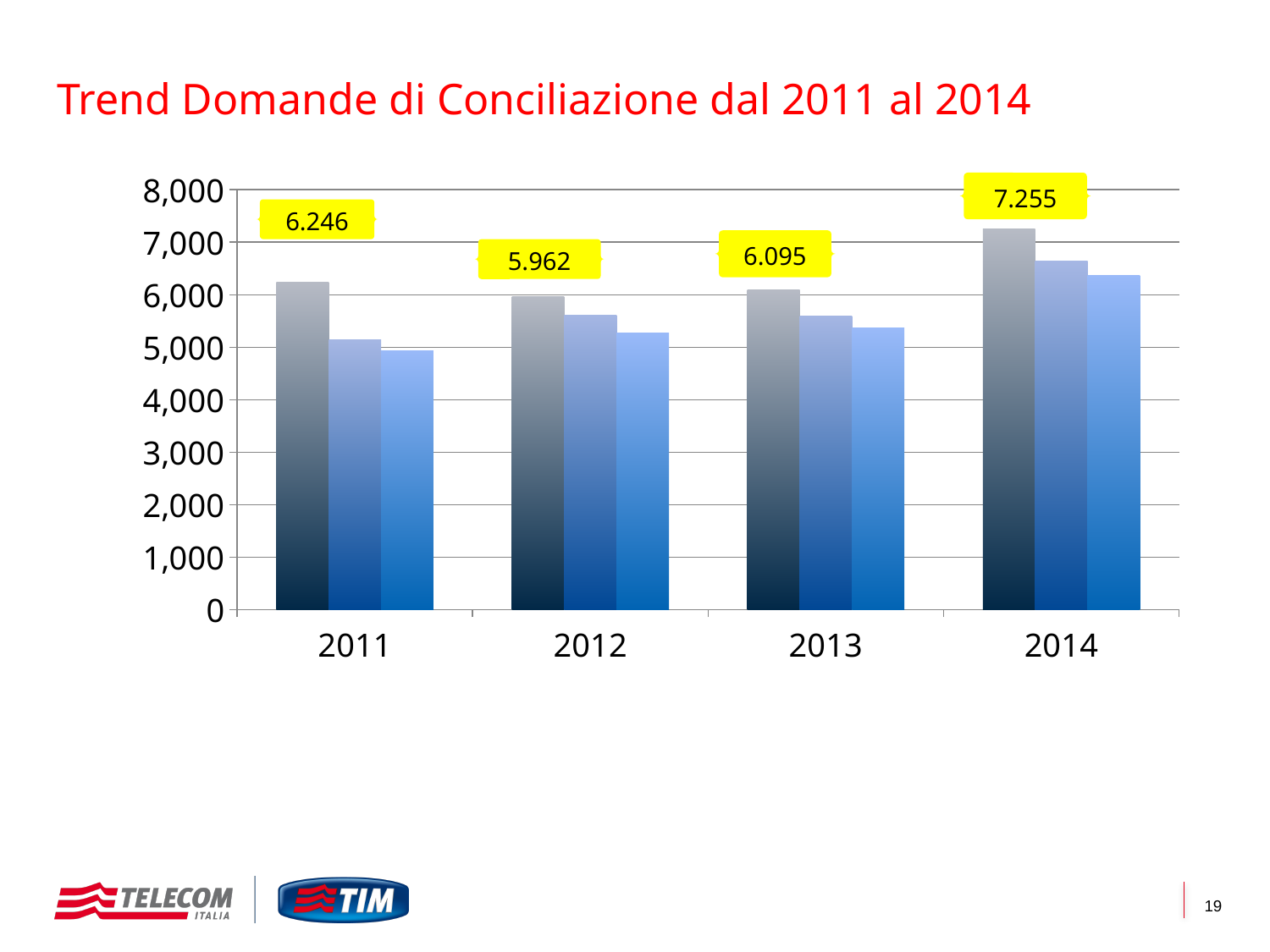
What kind of chart is shown on the slide? Bar chart What is the title of the slide? Trend Domande di Conciliazione dal 2011 al 2014 What is the labelled value for 2012? 5.962 What is the difference between the labelled values for 2014 and 2011? 1.009 Is the labelled value for 2013 larger than the labelled value for 2012? Yes, 2013 Is the value of the rightmost bar in the 2014 group greater or less than 6,000? greater Is the value of the middle bar in the 2012 group greater or less than 5,000? greater Which year has the highest labelled value? 2014 How many years are shown on the x axis? 4 What is the labelled value for 2014? 7.255 What is the labelled value for 2011? 6.246 Which year has the lowest labelled value? 2012